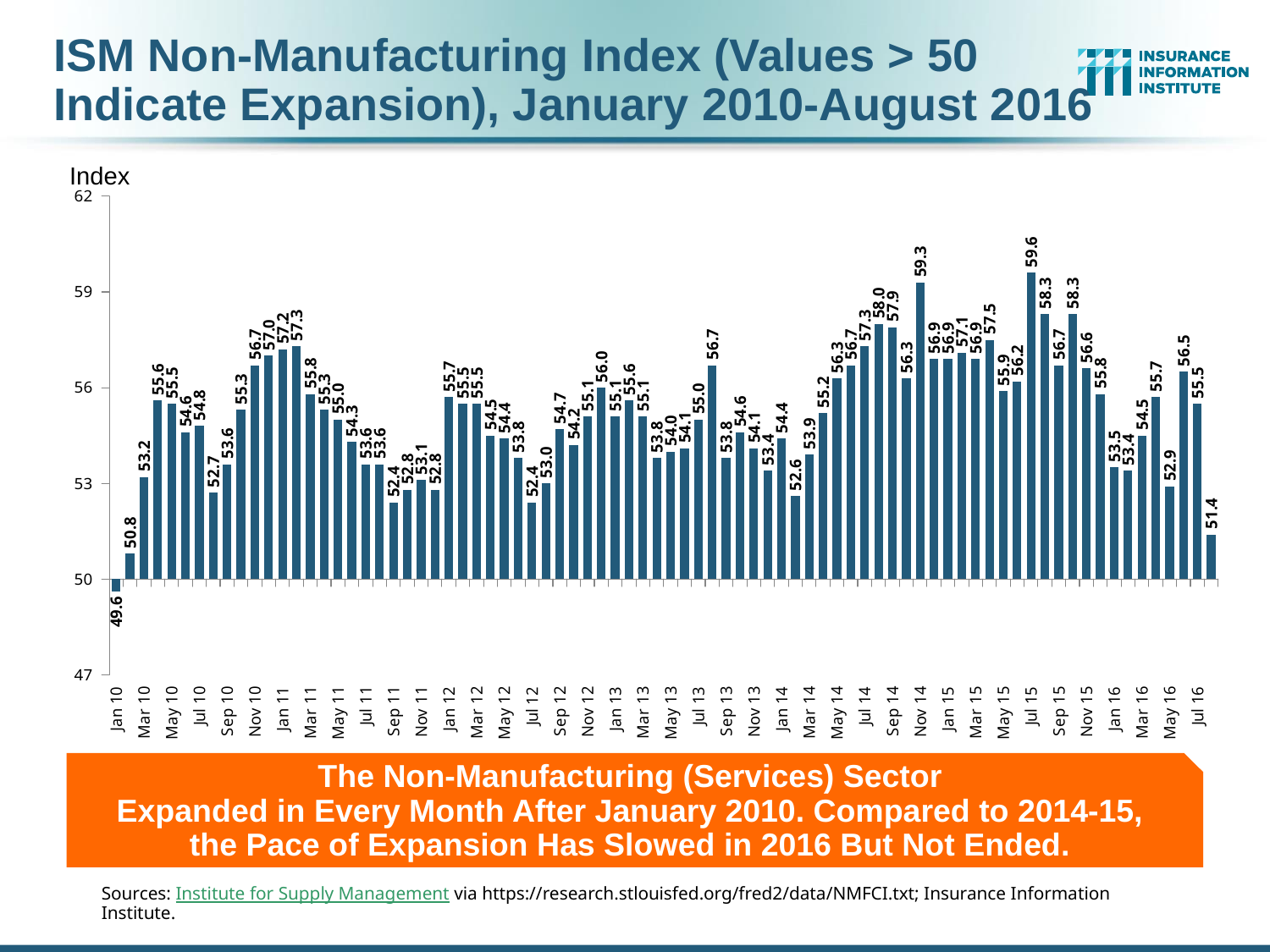
Is the value for Jan 10 greater or less than 50? less What label is shown on the vertical axis of the chart? Index What is the value of the last bar in the chart (Aug 2016)? 51.4 What is the ISM Non-Manufacturing Index value for Nov 14? 59.3 What kind of chart is shown on the slide? Bar chart What is the ISM Non-Manufacturing Index value for Jan 11? 57.2 What is the difference between the highest value (Jul 15) and the lowest value (Jan 10)? 10.0 What is the ISM Non-Manufacturing Index value for Jan 10? 49.6 What is the ISM Non-Manufacturing Index value for Jul 15? 59.6 Which month has the lowest ISM Non-Manufacturing Index value in the chart? Jan 10 Which month has the highest ISM Non-Manufacturing Index value in the chart? Jul 15 Which is larger, the value for Jan 16 or the value for Jan 15? Jan 15